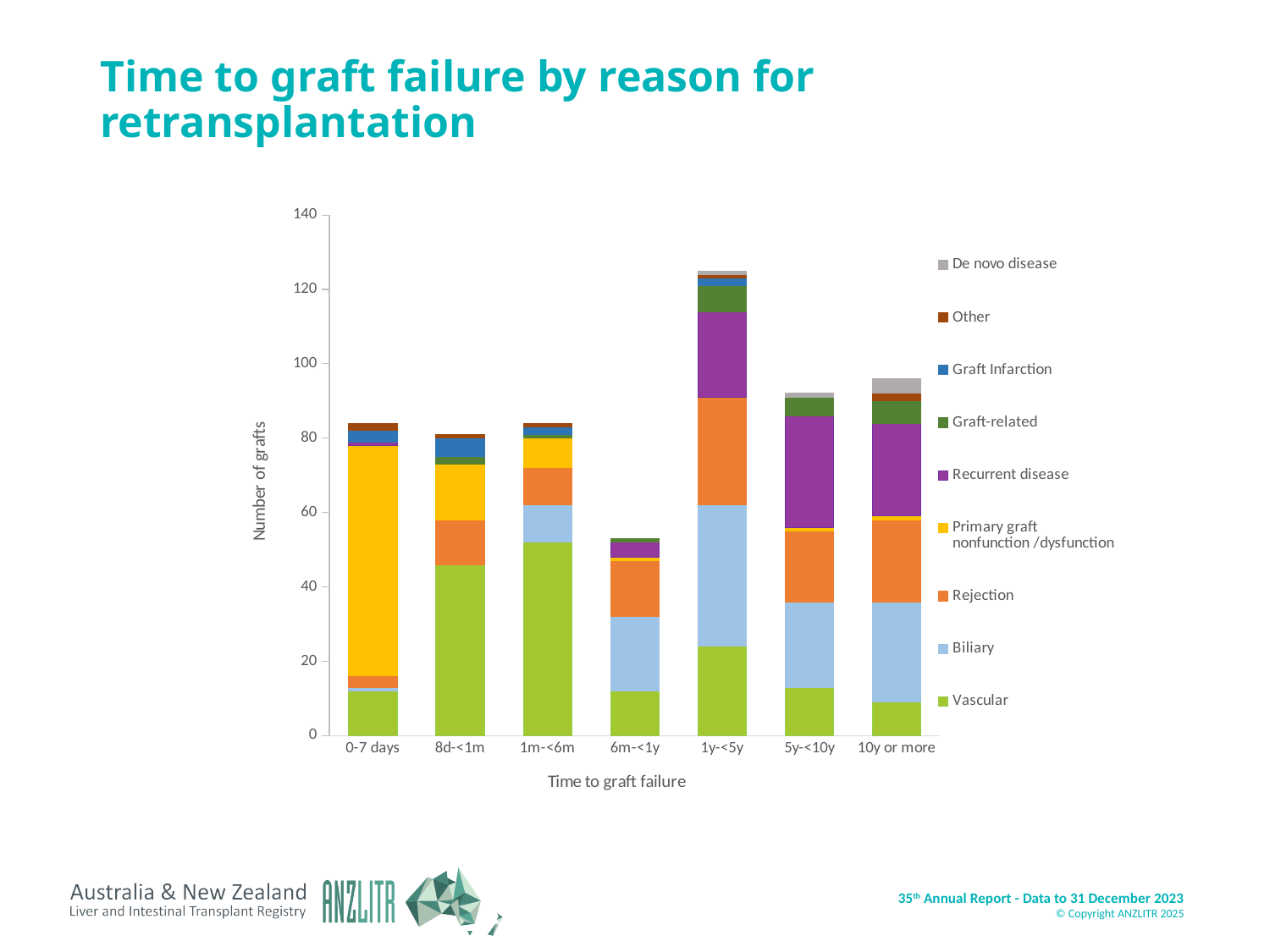
Is the total number of grafts for 1y-<5y greater or less than 120? greater Which series is shown in purple in the legend? Recurrent disease How many series does the legend list? 9 Is the total number of grafts for 5y-<10y greater or less than 100? less Which time-to-graft-failure category has the tallest stacked bar? 1y-<5y Which has a taller stacked bar, 1m-<6m or 6m-<1y? 1m-<6m How many time-to-graft-failure categories are shown on the x axis? 7 Which time-to-graft-failure category has the shortest stacked bar? 6m-<1y What kind of chart is shown on the slide? Stacked bar chart What is the label of the y axis? Number of grafts Which time-to-graft-failure category has the largest Primary graft nonfunction/dysfunction segment? 0-7 days Is the total number of grafts for 6m-<1y greater or less than 60? less